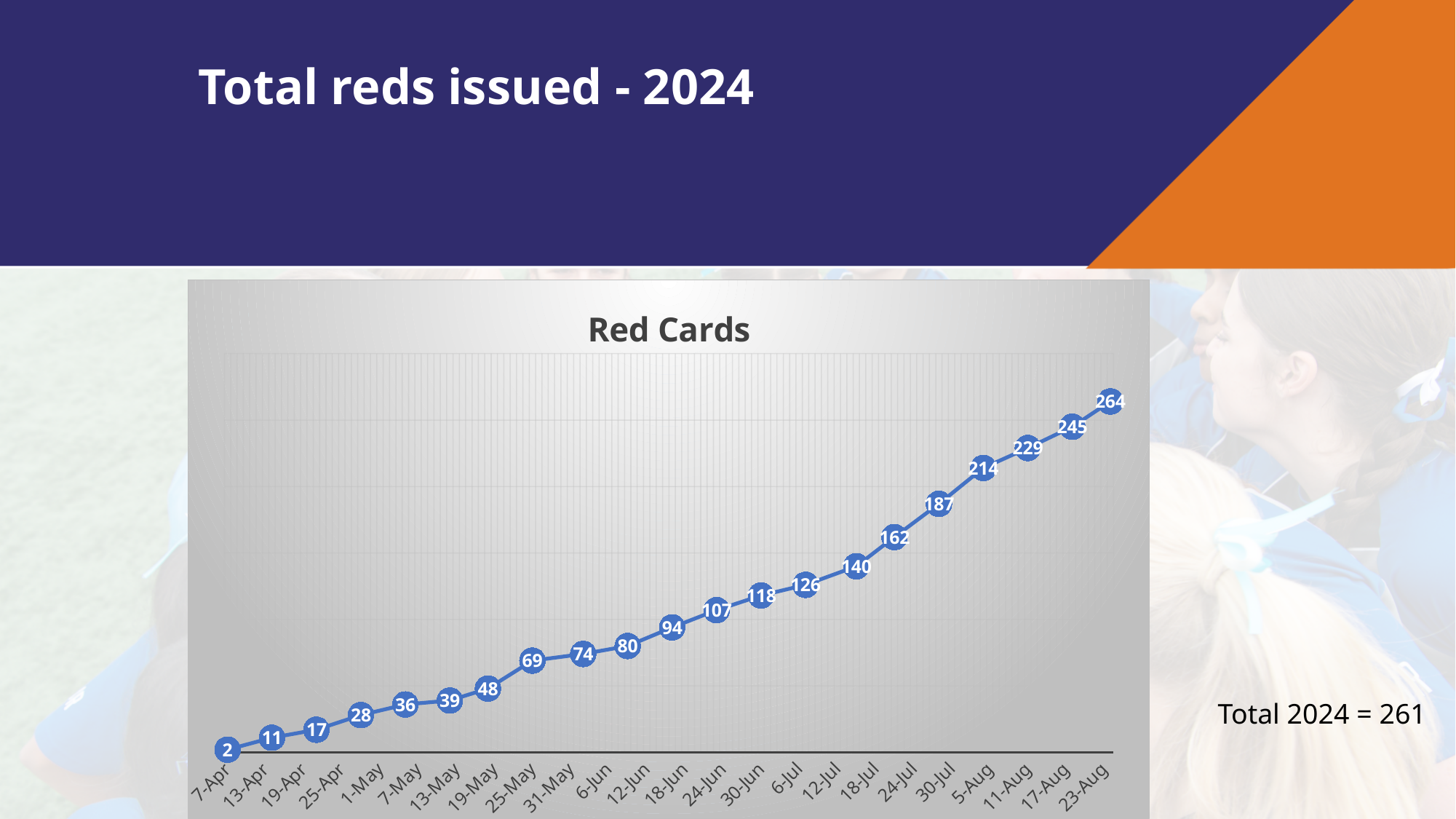
What is the highest value plotted on the chart? 264 What colour is the plotted line and its markers? blue Do the values rise or fall from left to right along the x axis? rise What is the value of the first data point, on 7-Apr? 2 What is the difference between the highest and lowest values on the chart? 262 What is the title of the chart? Red Cards How many data points are plotted on the line? 21 What is the lowest value plotted on the chart? 2 Which is larger, the value on 7-Apr or the value on 23-Aug? 23-Aug What is the difference between the last two data points, 245 and 264? 19 What is the value of the last data point, on 23-Aug? 264 What type of chart is shown on the slide? line chart